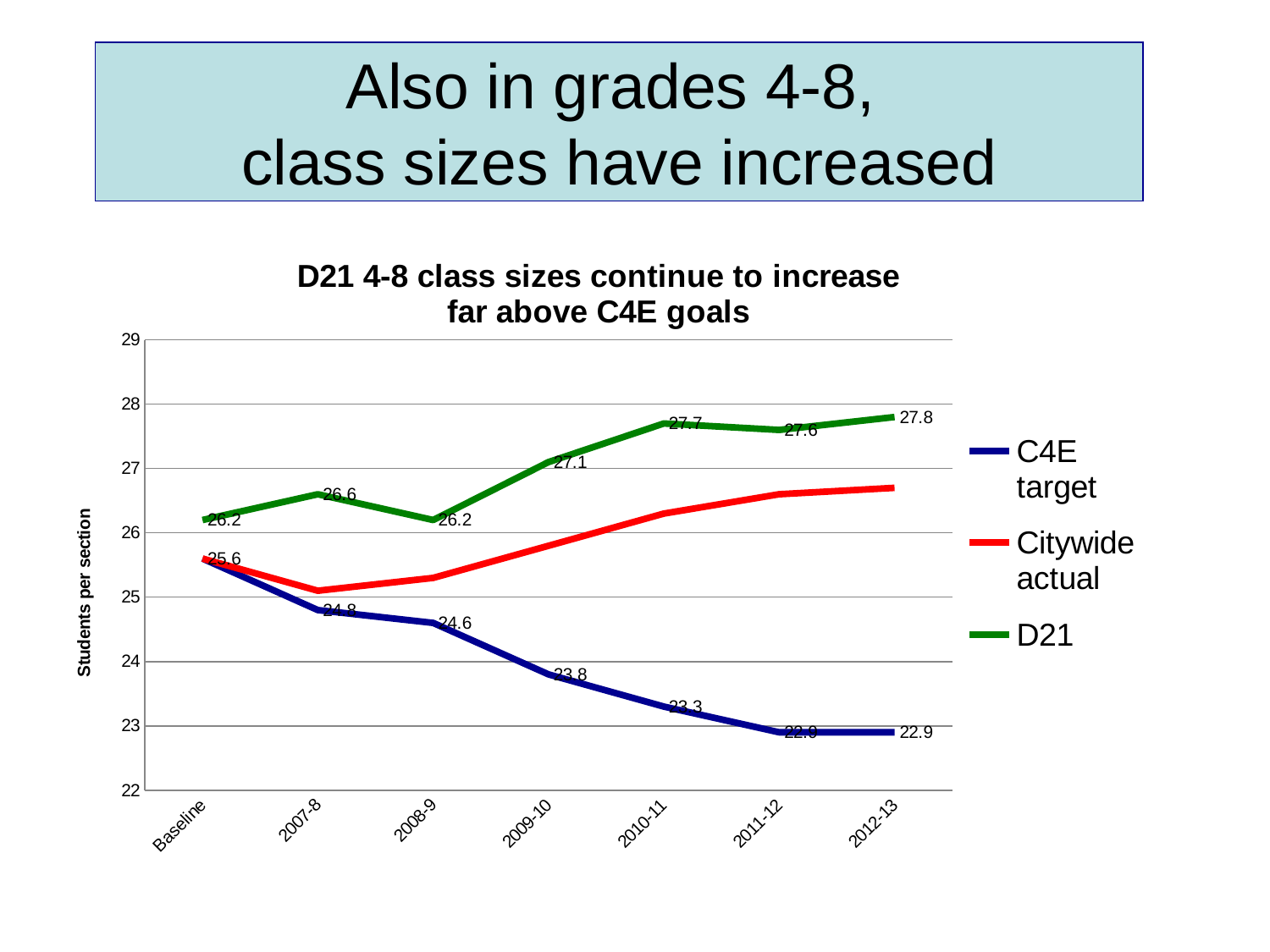
Does the C4E target series rise or fall from Baseline to 2012-13? fall In which year is the D21 series highest? 2012-13 Is the Citywide actual value for 2012-13 greater or less than 27? less What is the D21 value for 2012-13? 27.8 In which year is the C4E target series highest? Baseline How many points are plotted along the x axis for each series? 7 How many series does the legend list? 3 What kind of chart is shown on the slide? line chart What is the difference between the D21 value for 2012-13 and the D21 value at Baseline? 1.6 What is the C4E target value for 2009-10? 23.8 What is the D21 value for 2009-10? 27.1 Which is larger, the D21 value for 2010-11 or for 2011-12? 2010-11